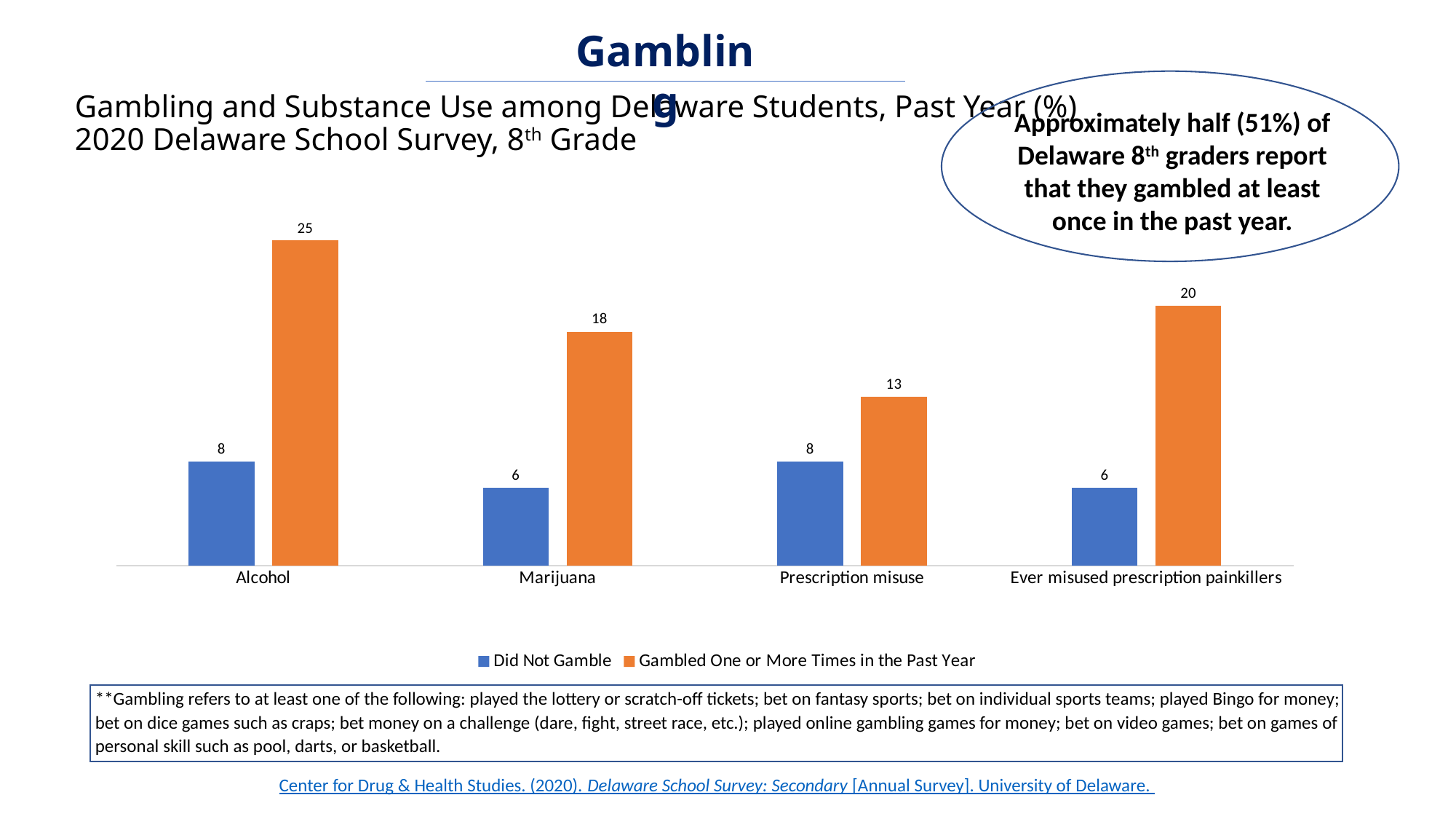
What is the difference between the Gambled One or More Times and Did Not Gamble values for Alcohol? 17 Which is larger: the Gambled One or More Times value for Marijuana or for Ever misused prescription painkillers? Ever misused prescription painkillers How many categories are shown on the x axis? 4 What is the value for Alcohol in the Gambled One or More Times in the Past Year series? 25 What kind of chart is shown on the slide? Bar chart What is the value for Marijuana in the Did Not Gamble series? 6 Which category has the highest value in the Gambled One or More Times in the Past Year series? Alcohol How many series does the legend list? 2 What is the value for Ever misused prescription painkillers in the Did Not Gamble series? 6 What is the difference between the Gambled One or More Times and Did Not Gamble values for Ever misused prescription painkillers? 14 Which category has the lowest value in the Gambled One or More Times in the Past Year series? Prescription misuse What is the value for Prescription misuse in the Gambled One or More Times in the Past Year series? 13